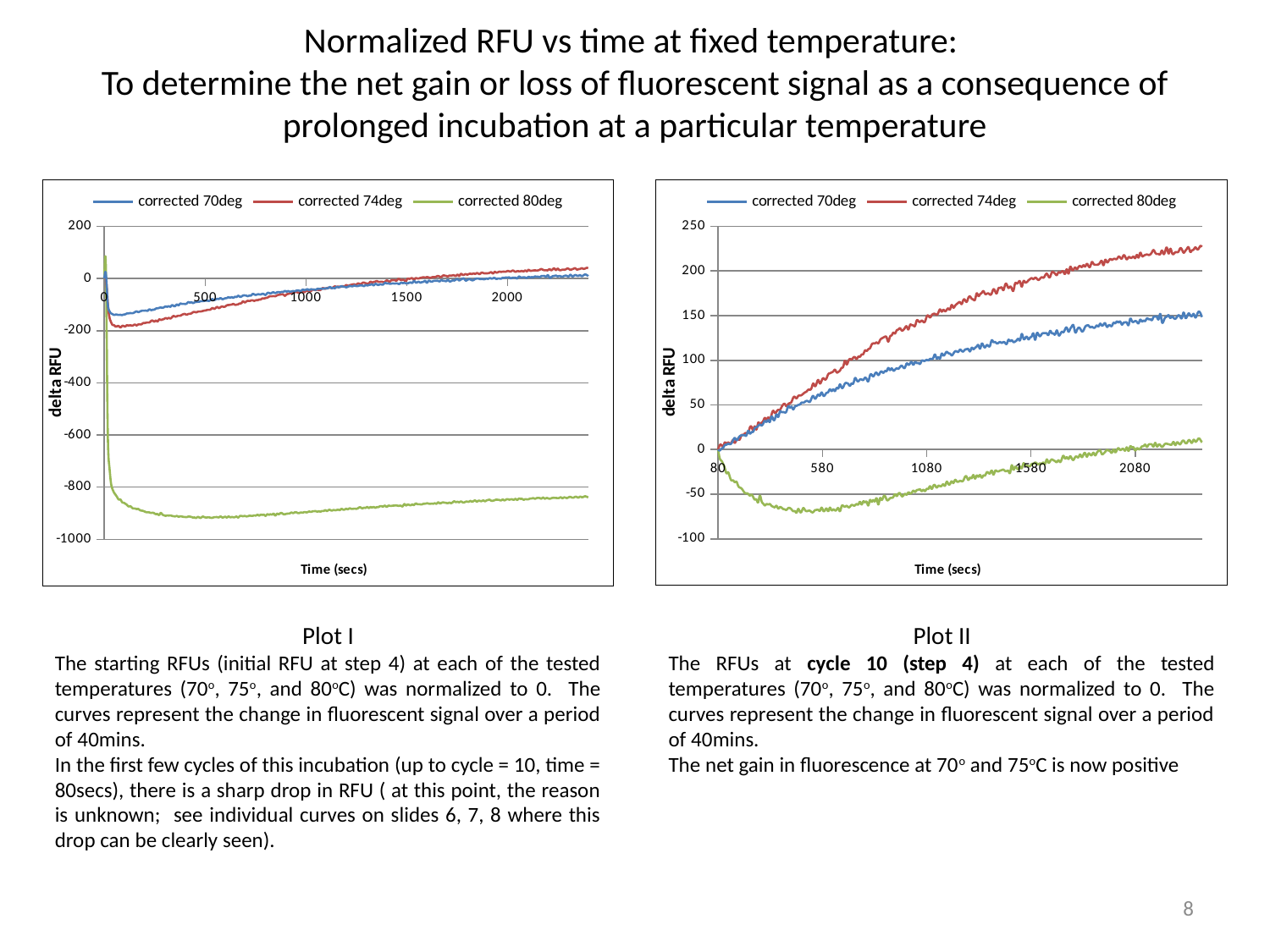
What kind of chart is Plot I (the left chart)? line chart In Plot I (the left chart), is the lowest value of the corrected 80deg series greater or less than -800? less In Plot II (the right chart), does the corrected 74deg series generally rise or fall over time? rise In Plot II (the right chart), is the final value of the corrected 70deg series greater or less than 200? less In Plot I (the left chart), which series reaches the lowest delta RFU value? corrected 80deg In Plot II (the right chart), which series is larger at 2080 seconds: corrected 70deg or corrected 80deg? corrected 70deg In Plot II (the right chart), is the final value of the corrected 74deg series greater or less than 200? greater What is the y-axis title of Plot II (the right chart)? delta RFU What are the legend entries in Plot I (the left chart)? corrected 70deg, corrected 74deg, corrected 80deg How many series does the legend of Plot II (the right chart) list? 3 In Plot II (the right chart), which series has the highest value at the end of the time range? corrected 74deg In Plot II (the right chart), which series has the lowest value at the end of the time range? corrected 80deg